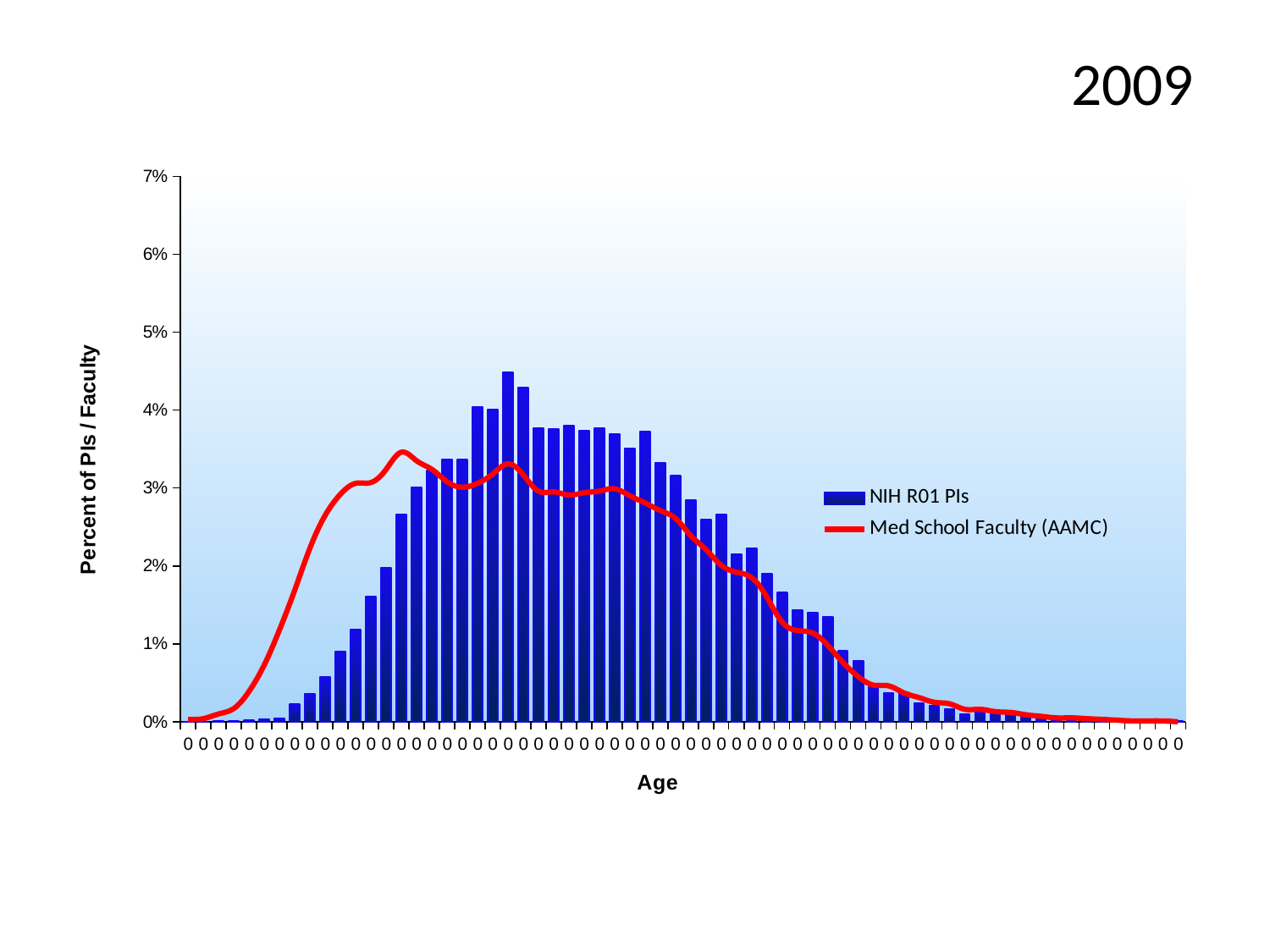
What are the two series named in the legend? NIH R01 PIs and Med School Faculty (AAMC) What kind of chart is shown on the slide? A bar chart with a line series overlaid Is the tallest NIH R01 PIs bar greater or less than 4%? greater Which series reaches the higher peak value, NIH R01 PIs or Med School Faculty (AAMC)? NIH R01 PIs Is the peak of the Med School Faculty (AAMC) line greater or less than 3%? greater What is the title of the vertical axis? Percent of PIs / Faculty Is the tallest NIH R01 PIs bar greater or less than 5%? less Toward the right end of the x axis, do the NIH R01 PIs bars rise or fall? fall How many series does the legend list? 2